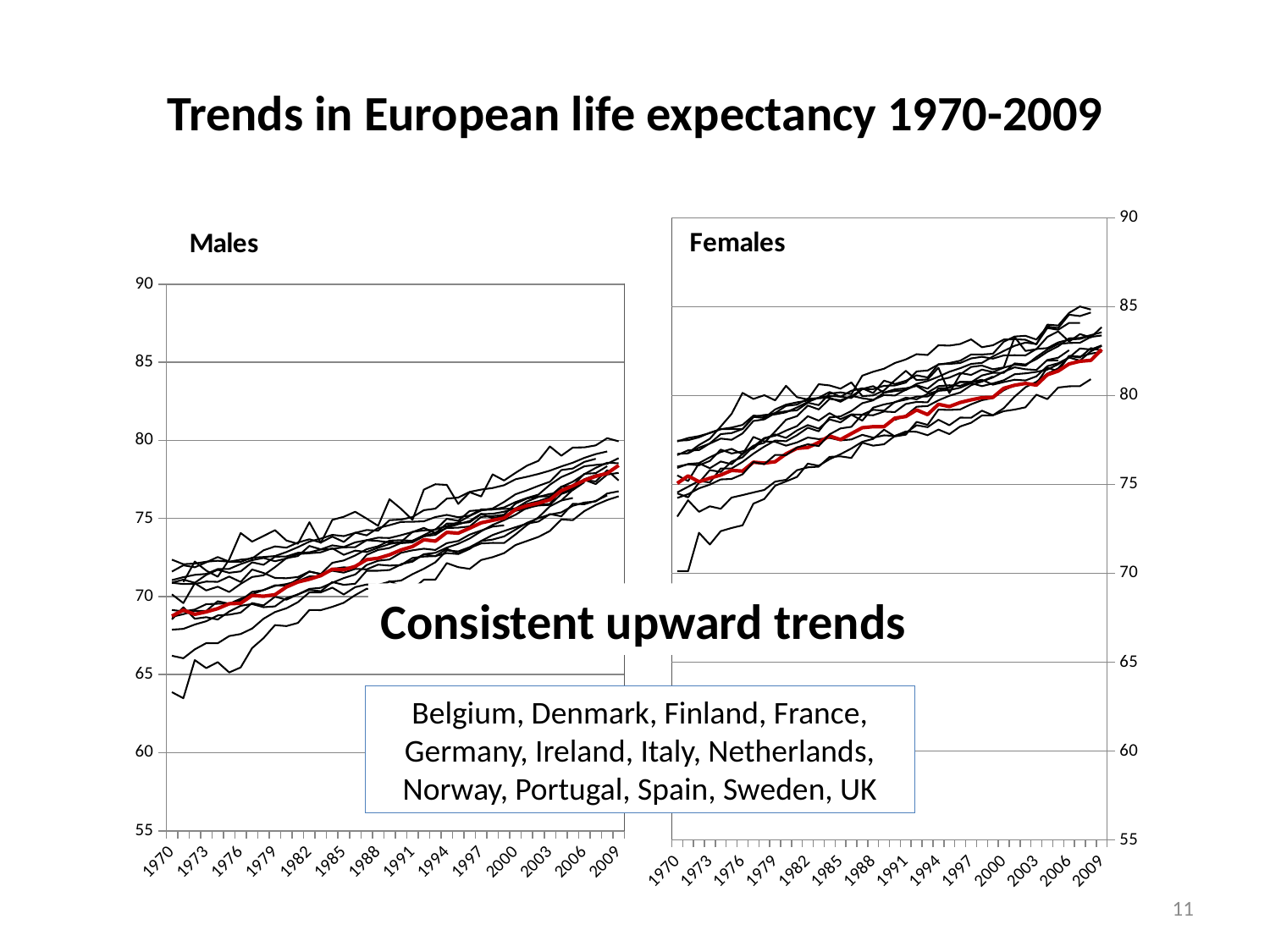
In the Females chart, do the life expectancy values rise or fall from 1970 to 2009? Rise In the Males chart, do the life expectancy values rise or fall from 1970 to 2009? Rise What kind of chart is used for the Males panel? Line chart Which chart is on the left of the slide, Males or Females? Males In the Females chart, is the value of the red line in 1990 greater or less than 75? greater In the Females chart, is the value of the red line in 2009 greater or less than 80? greater In the Males chart, is the value of the red line in 2009 greater or less than 75? greater What is the title of the slide? Trends in European life expectancy 1970-2009 How many countries are listed in the box on the slide? 13 How many charts are shown on the slide? 2